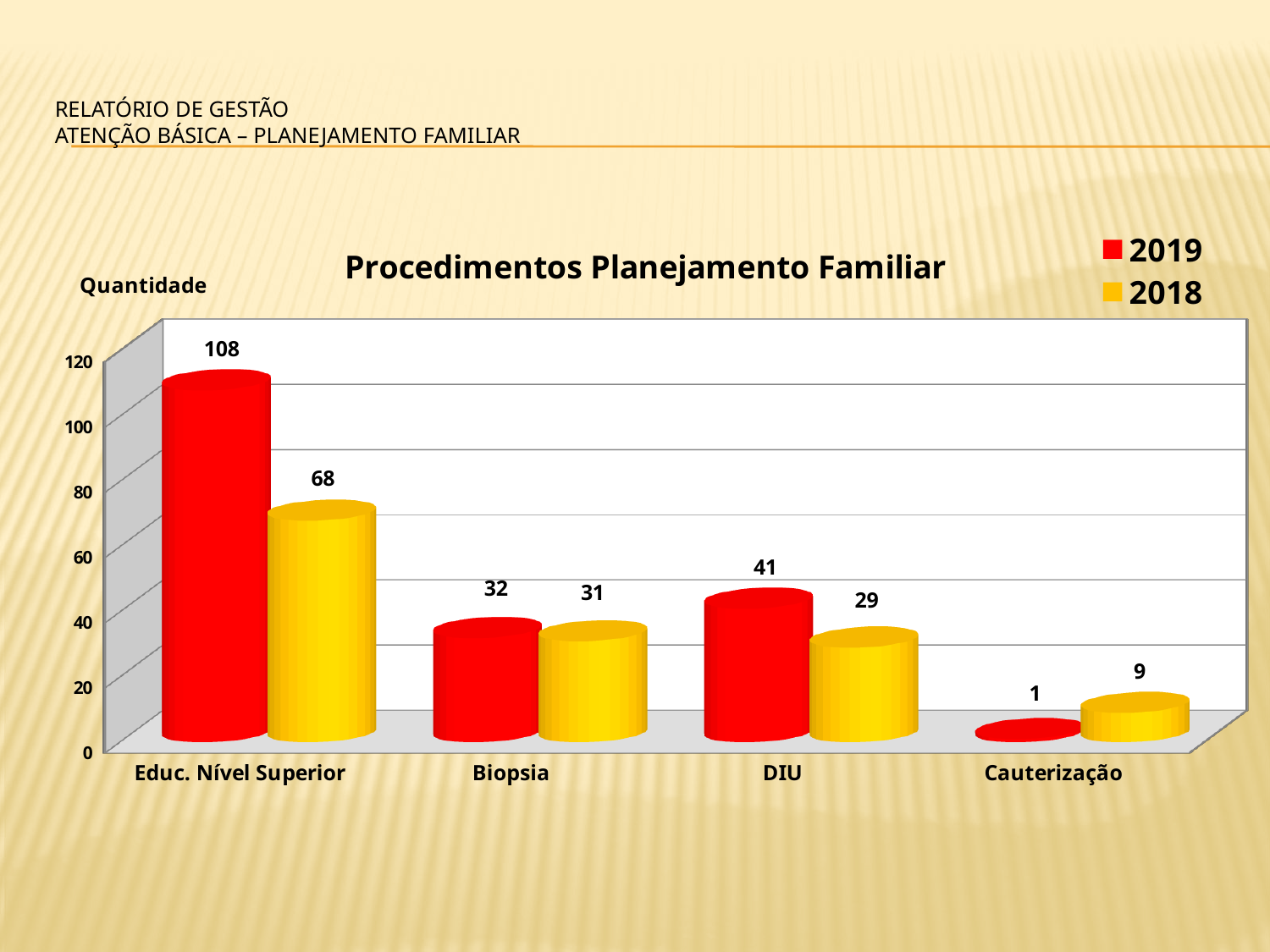
How many series does the legend list? 2 What is the difference between the 2019 and 2018 values for Educ. Nível Superior? 40 What kind of chart is shown on the slide? Bar chart Which is larger for Cauterização, the 2019 value or the 2018 value? 2018 What is the 2018 value for Cauterização? 9 Which category has the highest 2019 value? Educ. Nível Superior What is the 2019 value for Educ. Nível Superior? 108 What is the 2018 value for DIU? 29 Which category has the lowest 2019 value? Cauterização What is the title of the chart? Procedimentos Planejamento Familiar How many categories are shown on the x axis? 4 What is the difference between the 2019 and 2018 values for DIU? 12